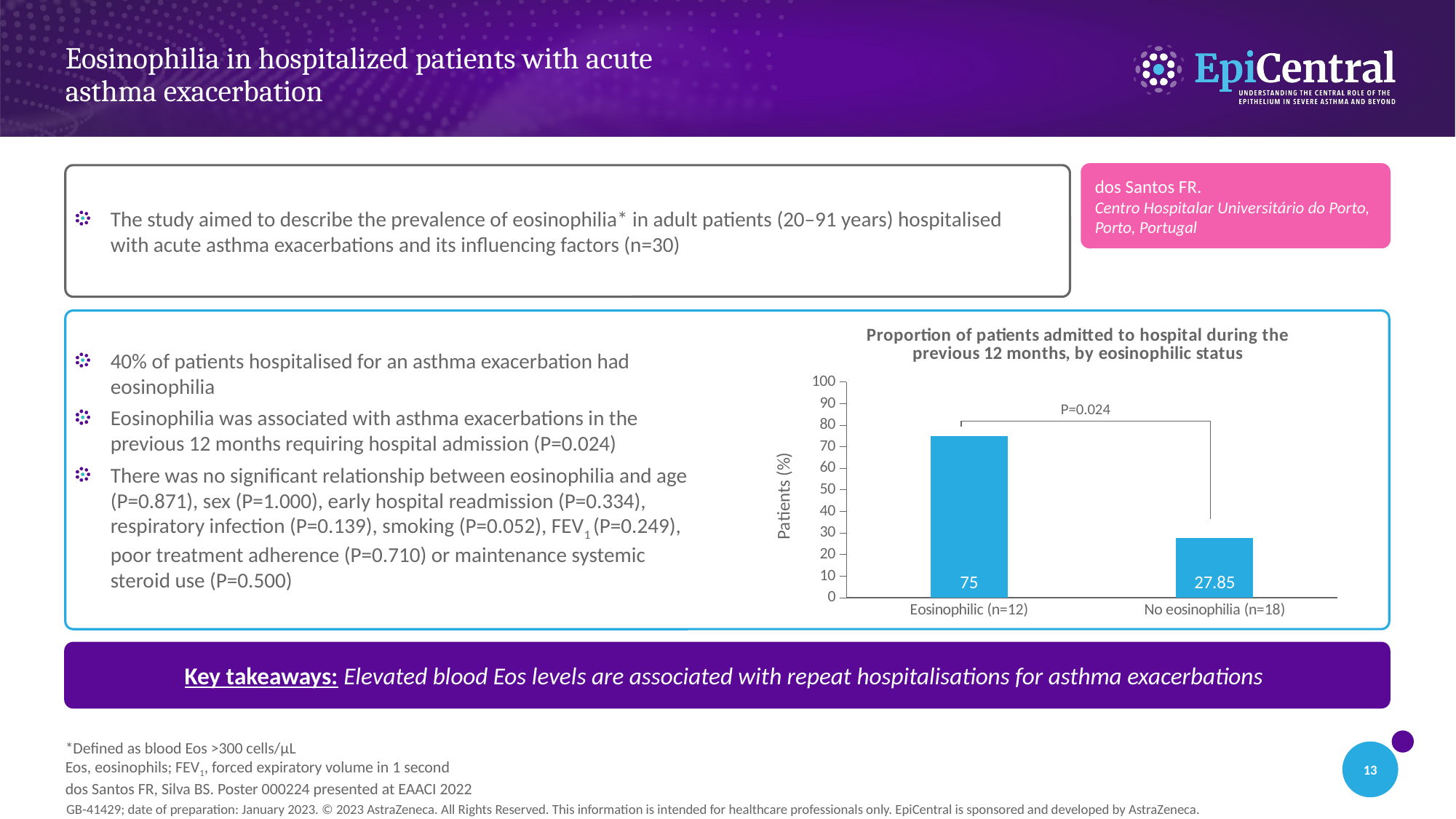
What kind of chart is shown? Bar chart What is the value for No eosinophilia (n=18)? 27.85 Which is larger, the value for Eosinophilic (n=12) or No eosinophilia (n=18)? Eosinophilic (n=12) What is the y-axis label of the chart? Patients (%) Is the value for No eosinophilia (n=18) greater or less than 30? less Is the value for Eosinophilic (n=12) greater or less than 70? greater What is the difference between the values for Eosinophilic (n=12) and No eosinophilia (n=18)? 47.15 Which category has the highest value? Eosinophilic (n=12) How many categories are shown on the x axis? 2 What is the value for Eosinophilic (n=12)? 75 Which category has the lowest value? No eosinophilia (n=18) What is the title of the chart? Proportion of patients admitted to hospital during the previous 12 months, by eosinophilic status